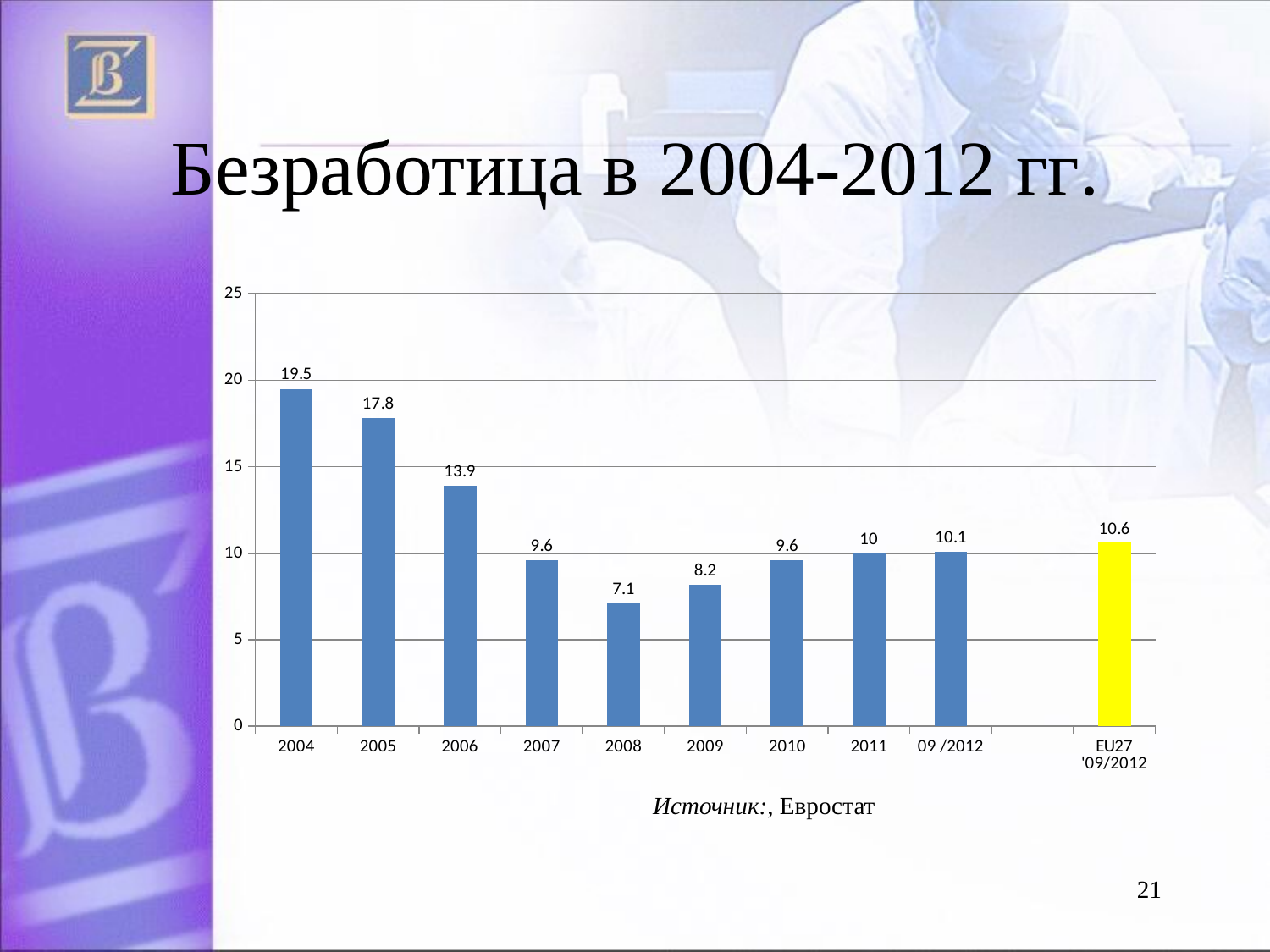
Is the value for 2006 greater or less than 15? less What is the value for 2004? 19.5 What is the value for 2008? 7.1 Do the values rise or fall from 2004 to 2008? fall What is the value for EU27 '09/2012? 10.6 What kind of chart is shown on the slide? bar chart Which category has the highest value? 2004 How many bars are shown in the chart? 10 Which category has the lowest value? 2008 What is the difference between the values for 2004 and 2005? 1.7 Which bar is coloured yellow? EU27 '09/2012 Which is larger, the value for 2009 or the value for 2011? 2011